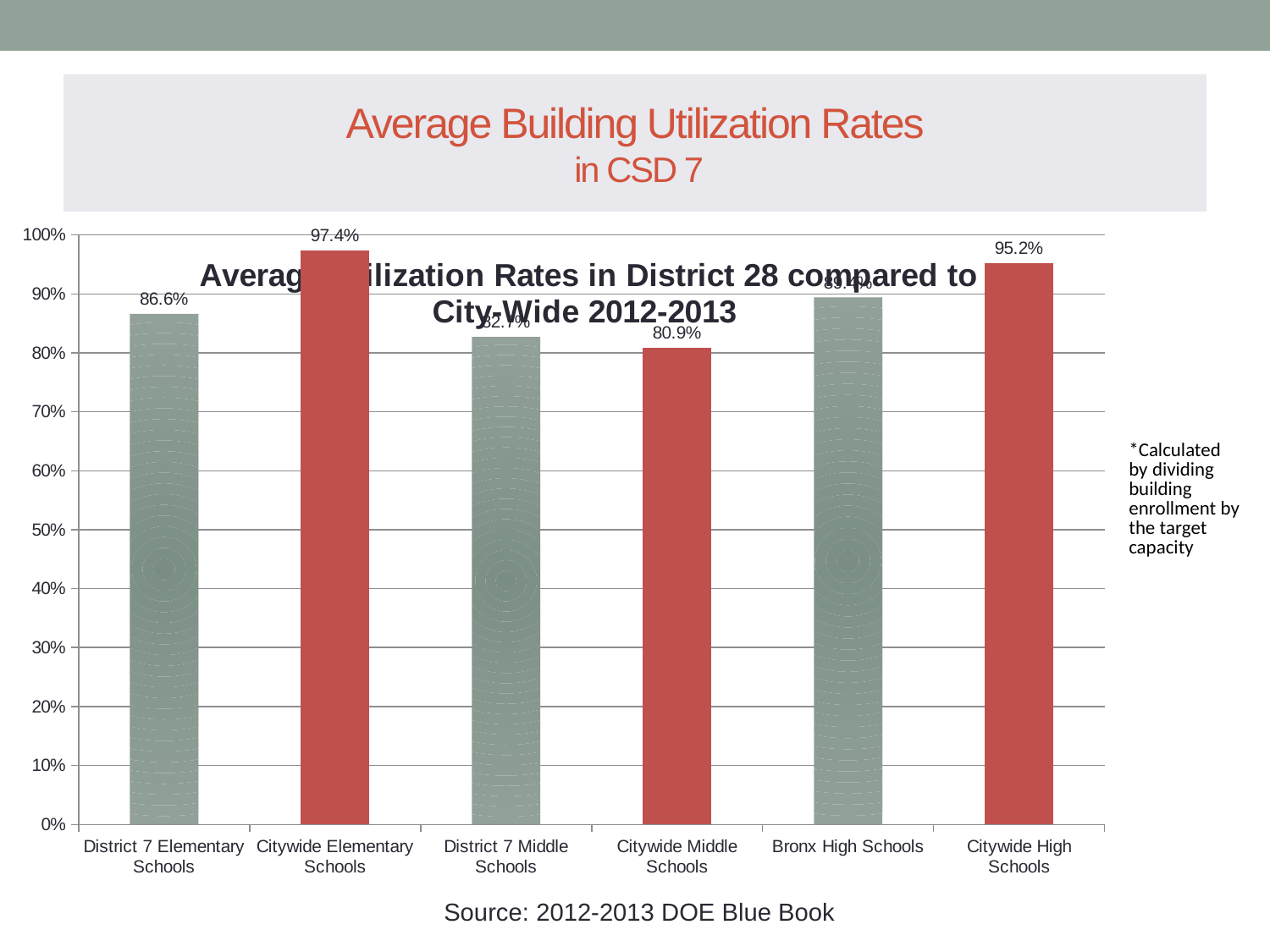
What is the average building utilization rate for District 7 Elementary Schools? 86.6% What is the average building utilization rate for Citywide Elementary Schools? 97.4% What is the average building utilization rate for Citywide High Schools? 95.2% How many categories are shown on the x axis of the chart? 6 Which category has the highest utilization rate? Citywide Elementary Schools Is the value for District 7 Middle Schools greater or less than 90%? less Which is larger, the utilization rate for Citywide Elementary Schools or for Citywide High Schools? Citywide Elementary Schools What kind of chart is shown on the slide? Bar chart Which category has the lowest utilization rate? Citywide Middle Schools How many percentage points higher is the Citywide Elementary Schools rate than the District 7 Elementary Schools rate? 10.8 percentage points Is the value for Bronx High Schools greater or less than 80%? greater What is the average building utilization rate for Citywide Middle Schools? 80.9%